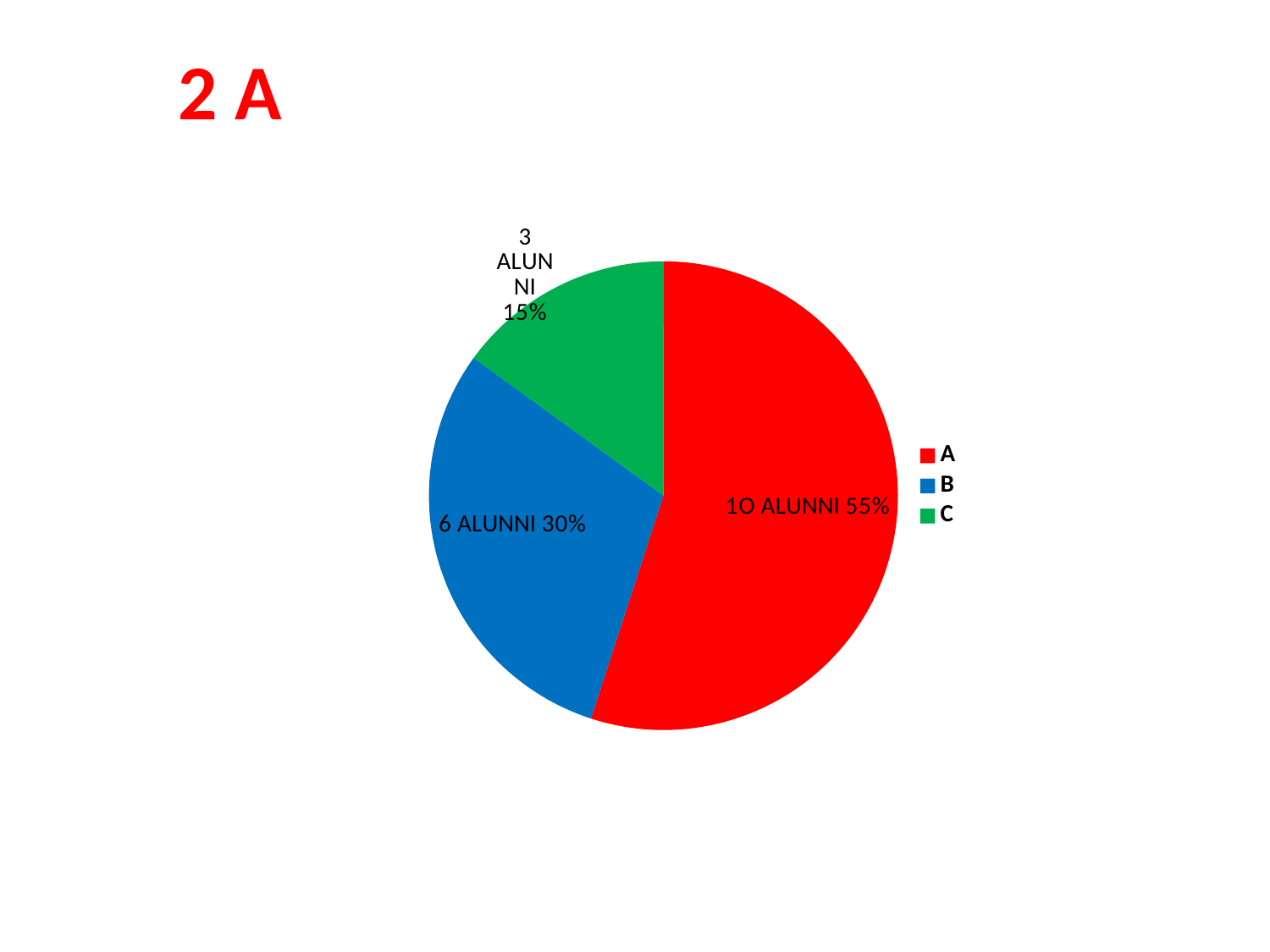
What colour is slice A in the pie chart? red What is the title shown on the slide? 2 A How many slices does the pie chart have? 3 How many entries does the legend list? 3 What is the difference in percentage points between slice A and slice B? 25% What percentage share does slice C have? 15% Which slice is the largest? A What percentage share does slice A have? 55% What kind of chart is shown on the slide? pie chart What percentage share does slice B have? 30% Which slice is larger, B or C? B Which slice is the smallest? C